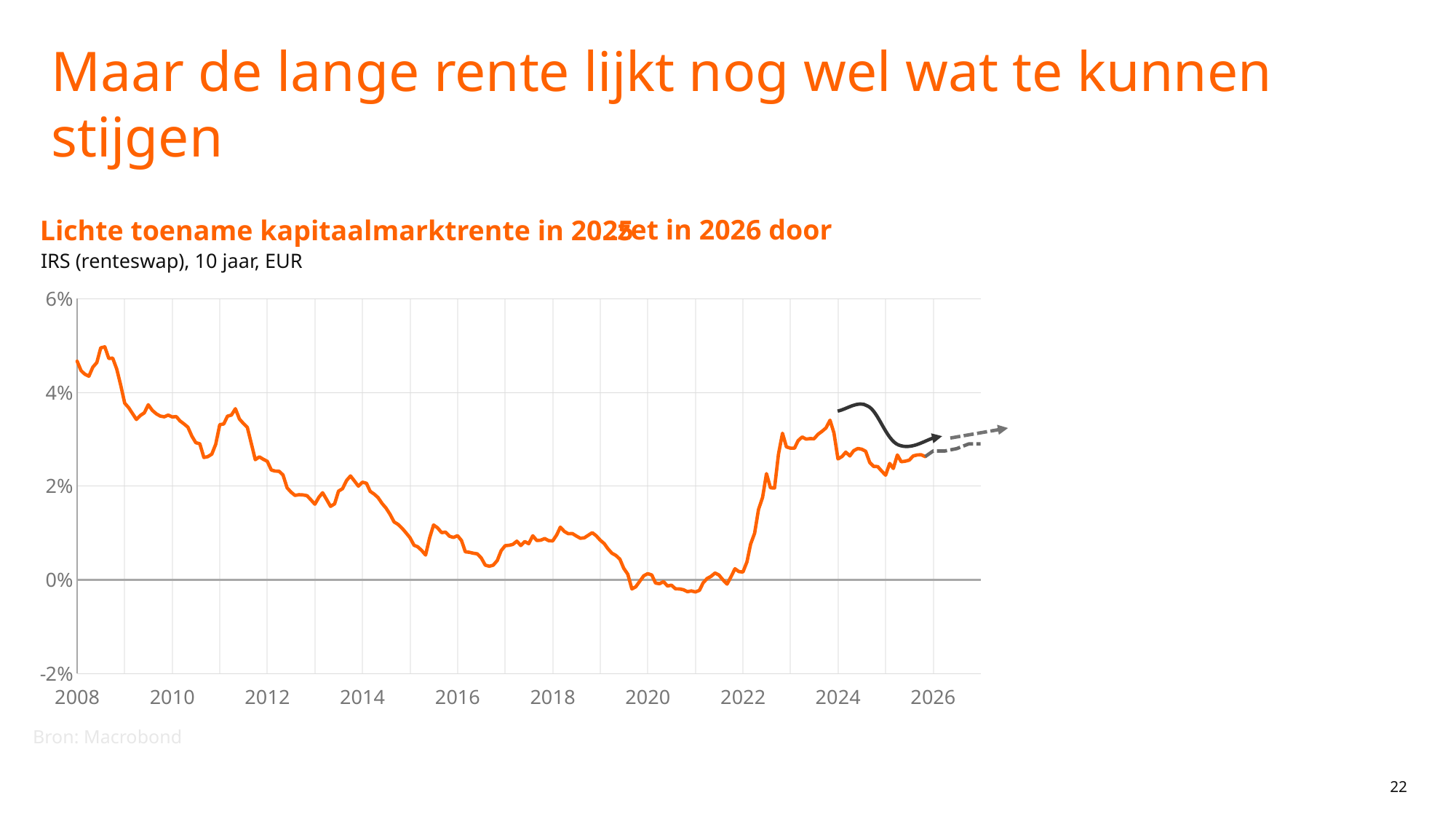
What source is cited below the chart? Macrobond Is the value at the start of 2008 greater or less than 4%? greater Around which year does the line reach its lowest level? 2021 Is the value at the start of 2023 greater or less than 2%? greater Does the line rise or fall between the start of 2022 and the start of 2023? rise What kind of chart is shown on the slide? line chart What is the highest value shown on the vertical axis? 6% Which is larger: the value at the start of 2008 or the value at the start of 2024? 2008 Is the value at the start of 2020 greater or less than 2%? less Does the line generally rise or fall between 2008 and 2020? fall Around which year does the line reach its highest level? 2008